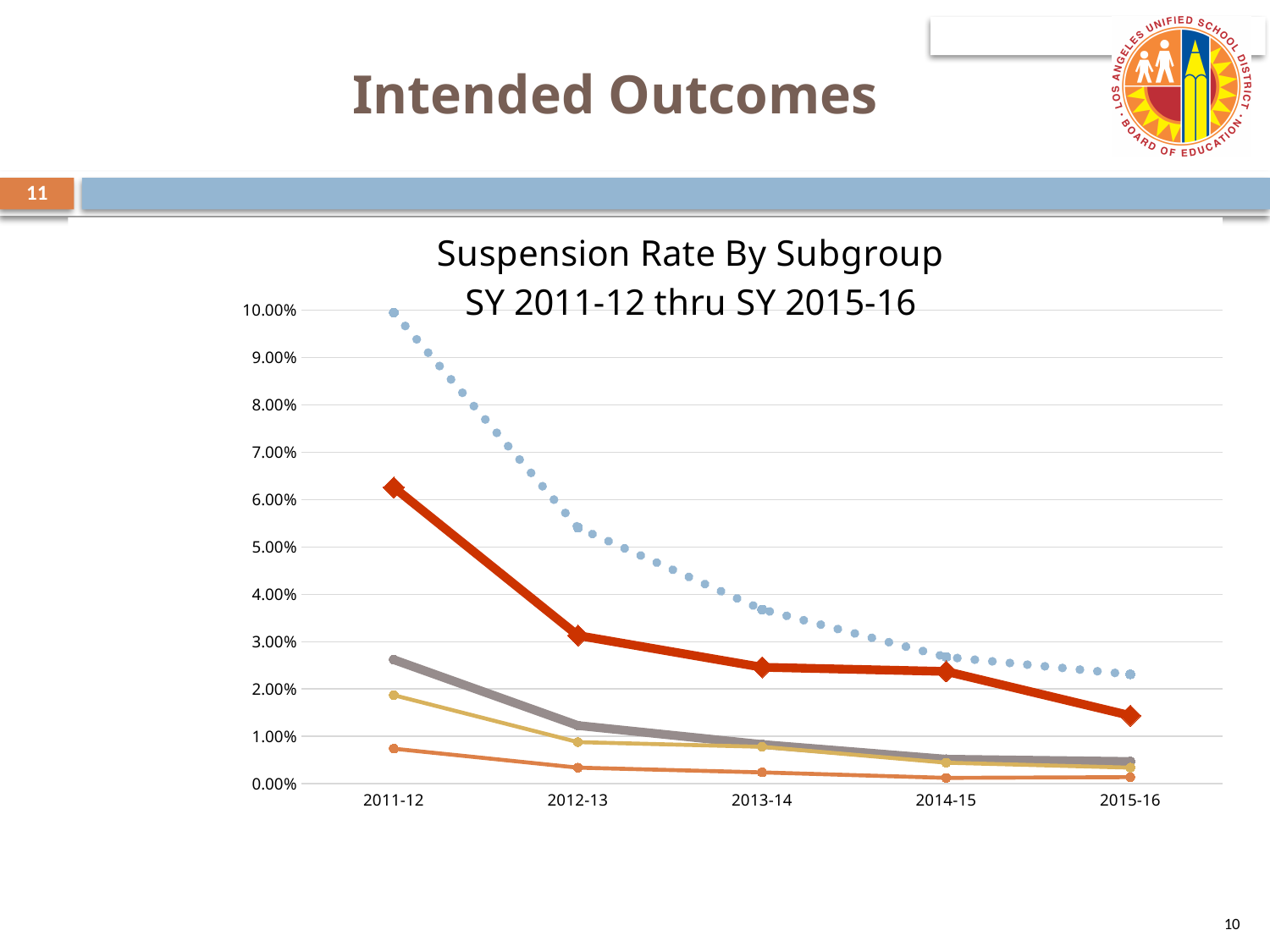
Is the value of the thick red line in 2011-12 greater or less than 5.00%? greater Is the value of the dotted blue line in 2011-12 greater or less than 9.00%? greater Is the value of the thick red line in 2015-16 greater or less than 2.00%? less How many school years are shown on the x axis? 5 In 2011-12, which is higher: the dotted blue line or the thick red line? the dotted blue line Which line has the highest values across all years? the dotted blue line Do the suspension rates rise or fall from 2011-12 to 2015-16? fall What kind of chart is shown on the slide? line chart How many lines are plotted on the chart? 5 What is the title of the chart? Suspension Rate By Subgroup SY 2011-12 thru SY 2015-16 What is the highest value shown on the y axis? 10.00%